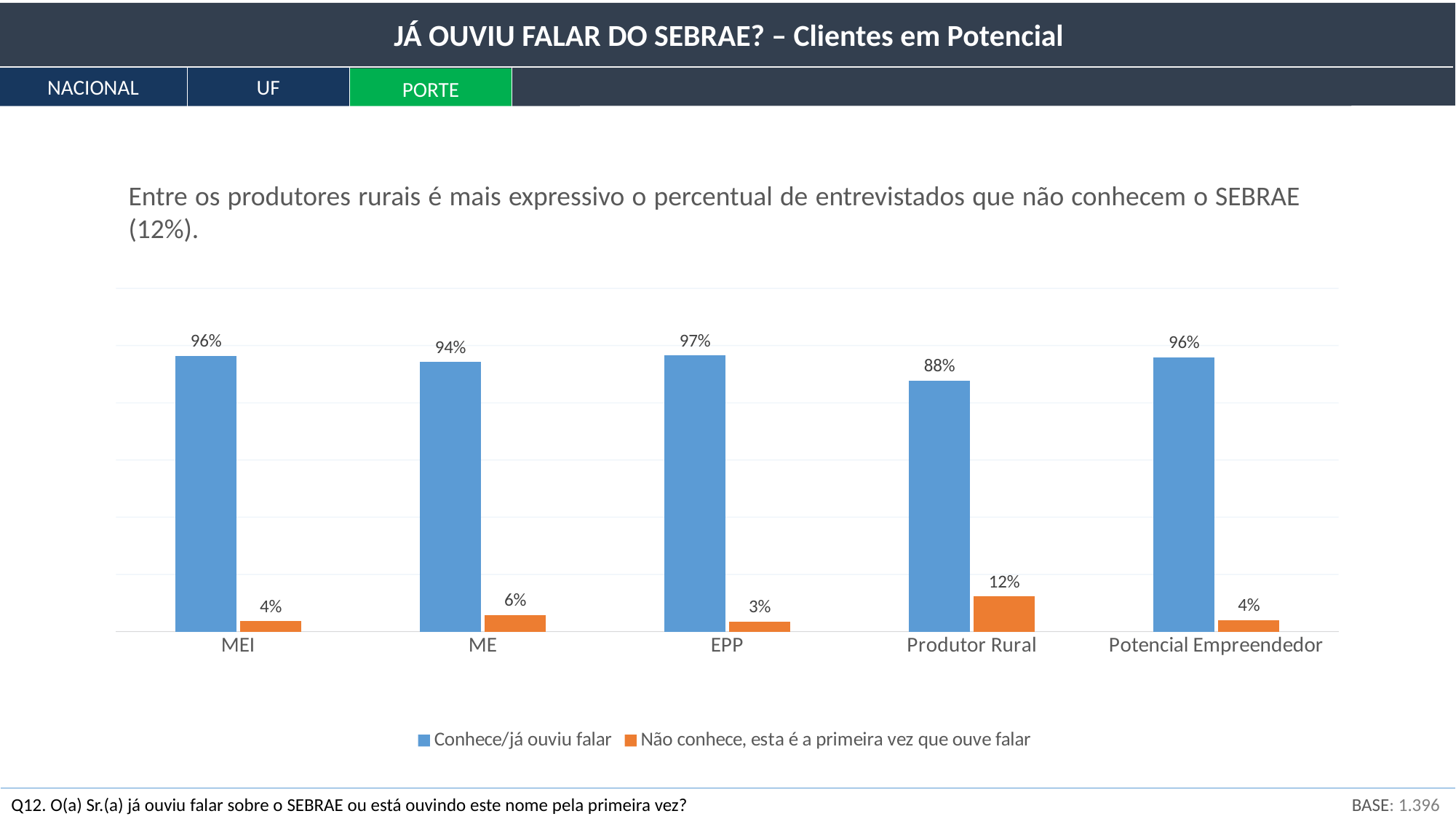
Which category has the highest value for "Conhece/já ouviu falar"? EPP Which is larger: the "Não conhece" value for ME or for MEI? ME What is the value of "Conhece/já ouviu falar" for EPP? 97% What is the value of "Não conhece, esta é a primeira vez que ouve falar" for ME? 6% What is the value of "Não conhece, esta é a primeira vez que ouve falar" for Produtor Rural? 12% What kind of chart is shown on the slide? Bar chart Which category has the lowest value for "Conhece/já ouviu falar"? Produtor Rural What is the value of "Conhece/já ouviu falar" for MEI? 96% How many categories are shown on the x axis? 5 What is the difference between the "Conhece/já ouviu falar" values for EPP and Produtor Rural? 9% Which category has the lowest value for "Não conhece, esta é a primeira vez que ouve falar"? EPP How many series does the legend list? 2